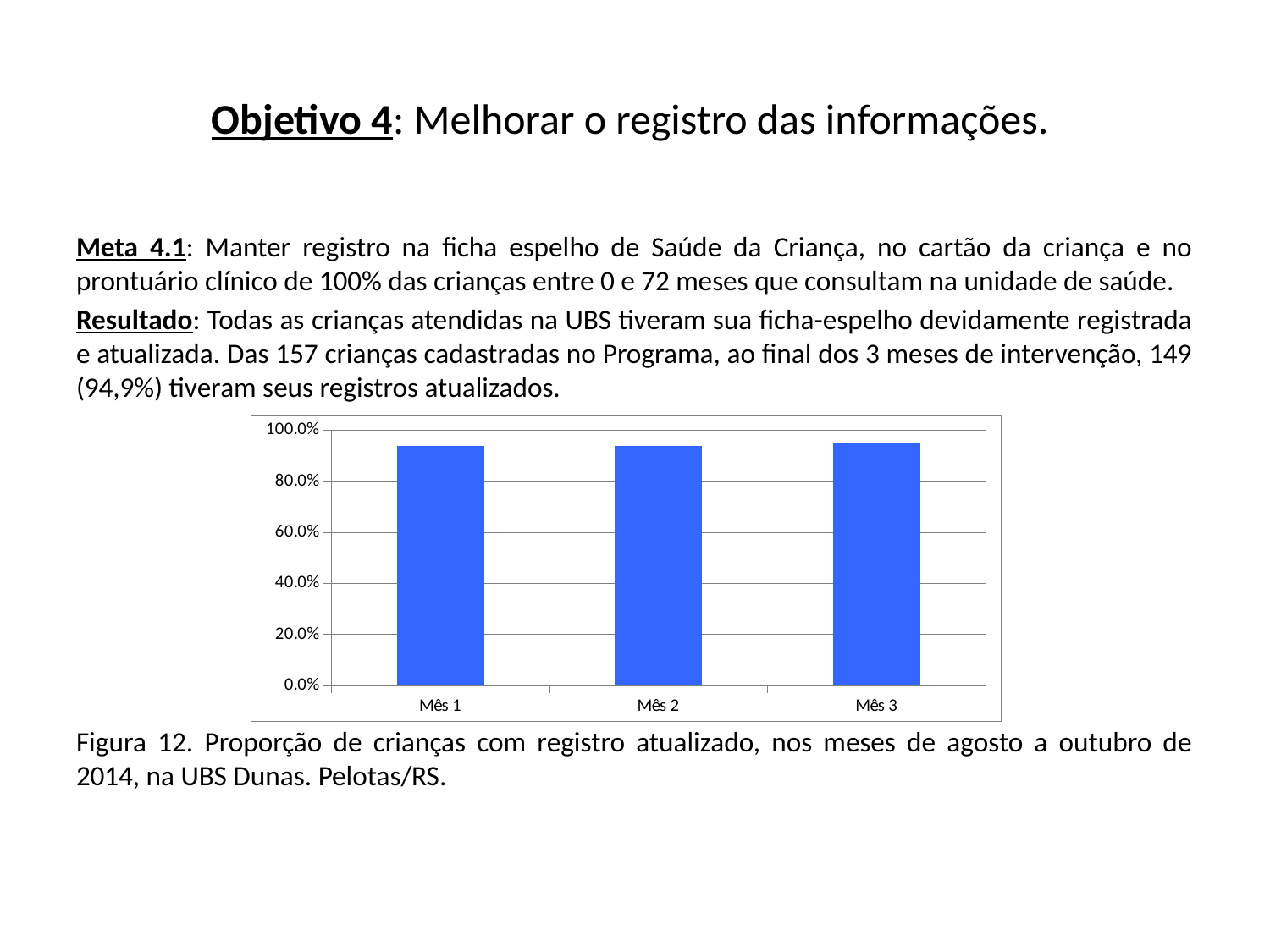
What kind of chart is shown on the slide? bar chart Is the value for Mês 1 greater or less than 100.0%? less Is the value for Mês 1 greater or less than 80.0%? greater Is the value for Mês 3 greater or less than 100.0%? less What is the highest value shown on the y axis of the chart? 100.0% What is the label of the first category on the x axis of the chart? Mês 1 How many categories (months) are shown on the x axis of the chart? 3